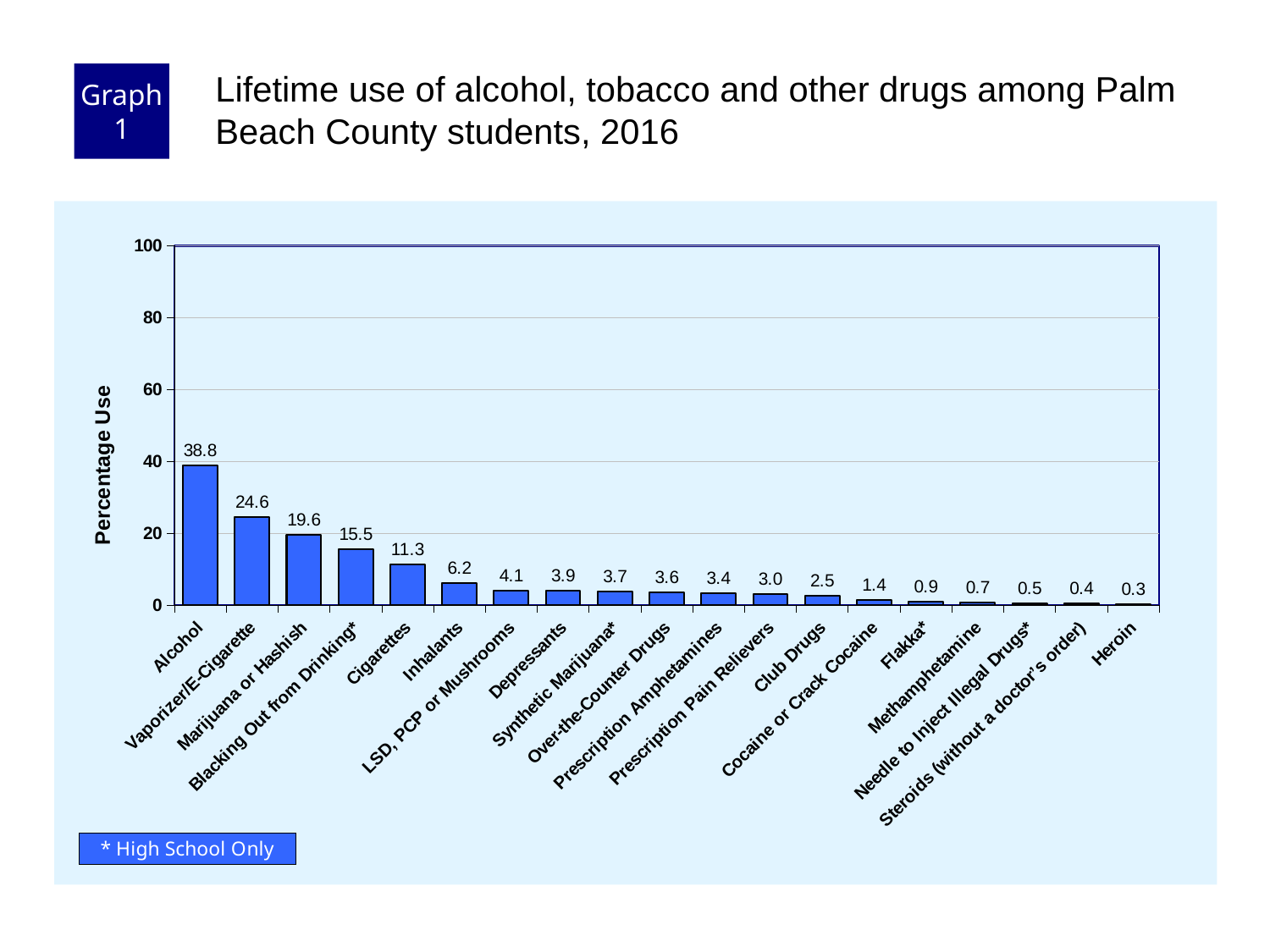
How many categories are shown on the x axis? 19 What is the percentage use for Club Drugs? 2.5 Which has a higher percentage use, Inhalants or Depressants? Inhalants Is the value for Blacking Out from Drinking* greater or less than 20? less Which category has the highest percentage use? Alcohol What is the percentage use for Cigarettes? 11.3 What is the difference in percentage use between Alcohol and Vaporizer/E-Cigarette? 14.2 What is the label of the y axis? Percentage Use What kind of chart is shown on the slide? Bar chart Which category has the lowest percentage use? Heroin What is the percentage use for Alcohol? 38.8 What is the difference in percentage use between Marijuana or Hashish and Cigarettes? 8.3